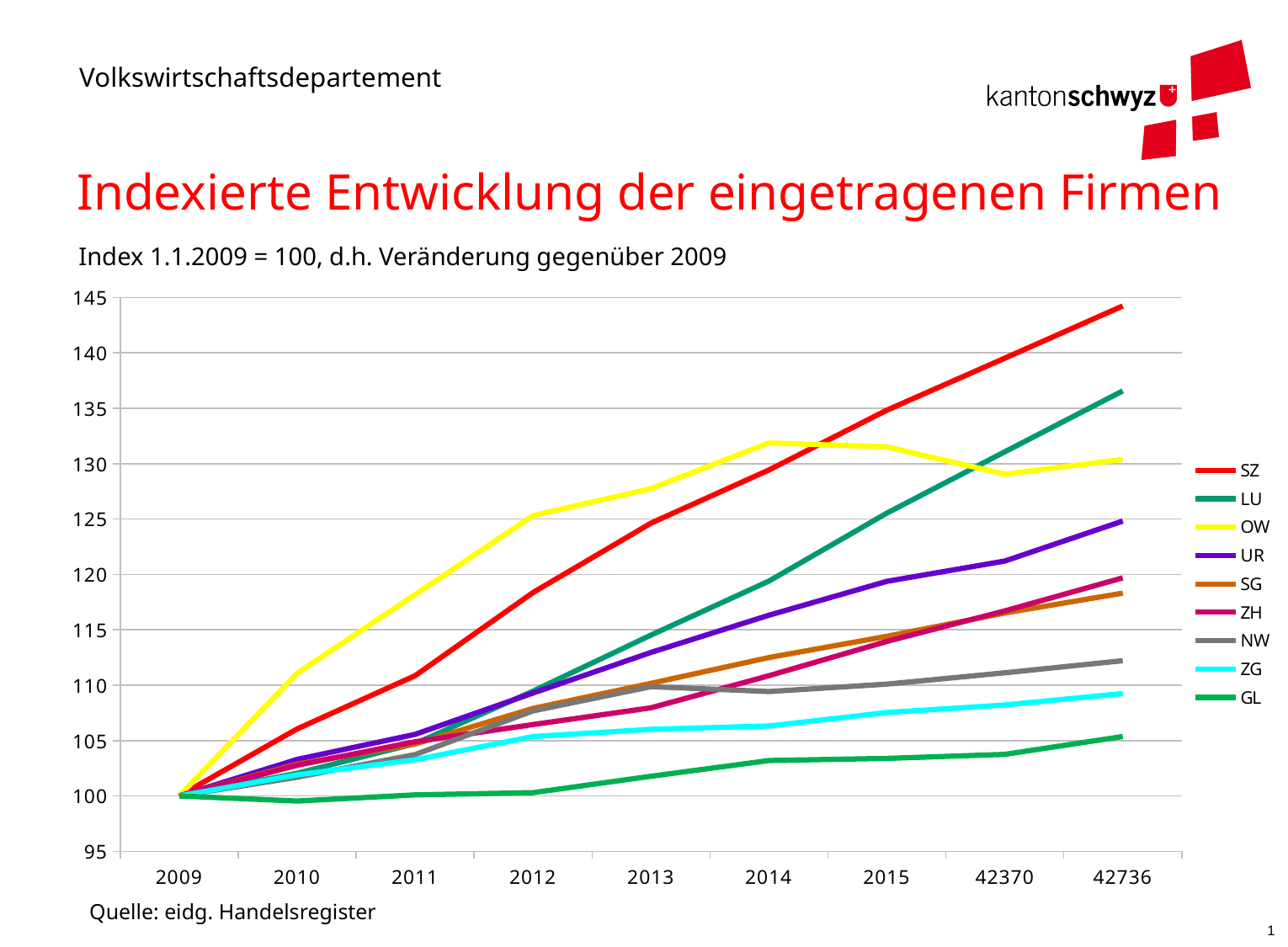
Does the SZ line rise or fall from 2009 to 42736? rise What is the index value for SZ in 2009? 100 Is the value for ZG at 42736 greater or less than 110? less Is the value for SZ at 42736 greater or less than 140? greater What colour is the SZ line? red Which series has the highest value at the last point on the x axis (42736)? SZ What kind of chart is shown on the slide? line chart Is the value for OW in 2014 greater or less than 130? greater How many points are there along the x axis? 9 Which is larger in 2012, the value for OW or the value for SZ? OW Which series has the lowest value at the last point on the x axis (42736)? GL How many series does the legend list? 9